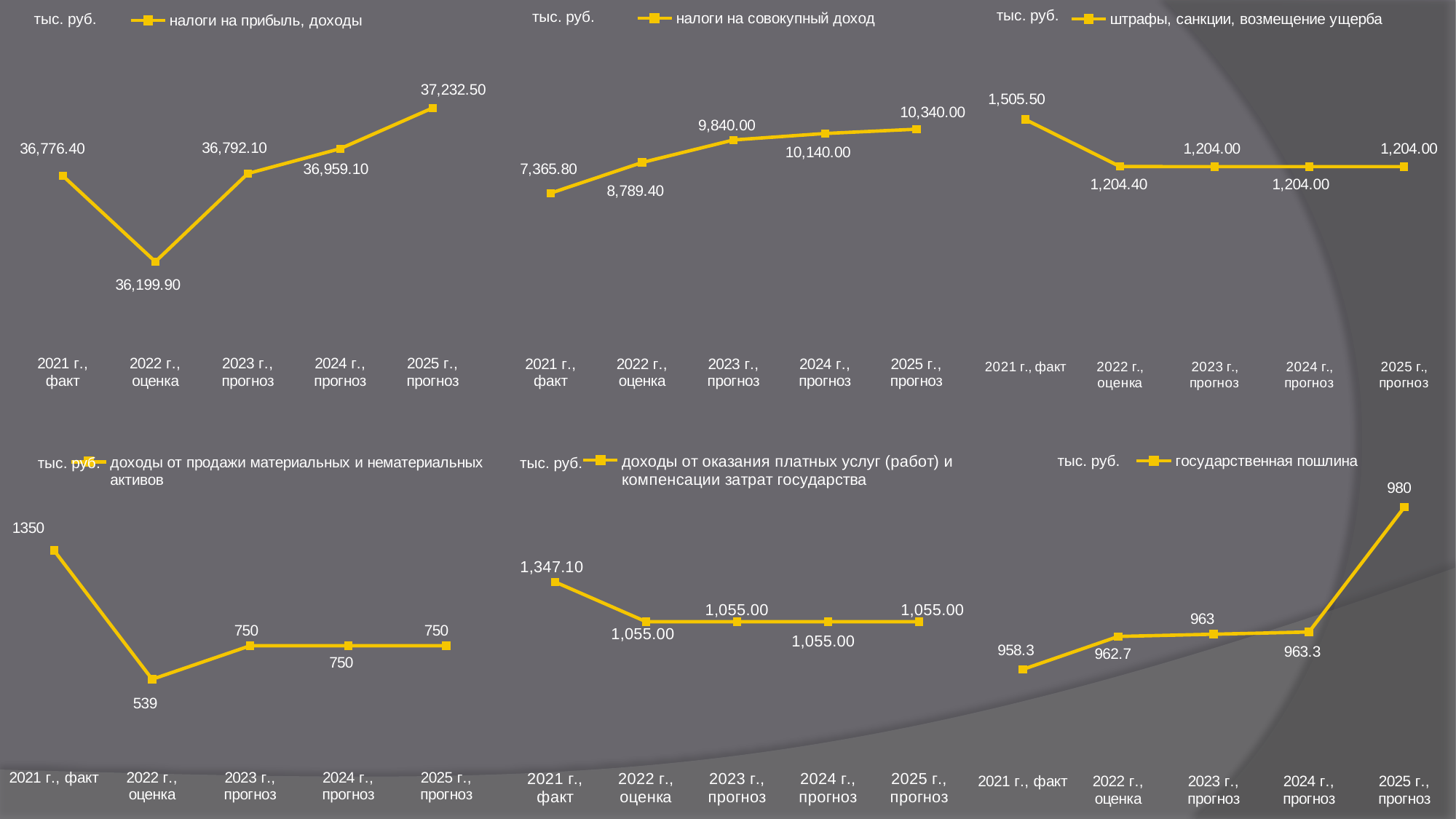
In the chart titled 'штрафы, санкции, возмещение ущерба', what is the value for 2021 г., факт? 1,505.50 In the chart titled 'налоги на прибыль, доходы', which year has the highest value? 2025 г., прогноз In the chart titled 'налоги на совокупный доход', what is the difference between the 2025 г., прогноз value and the 2021 г., факт value? 2,974.20 In the chart titled 'доходы от продажи материальных и нематериальных активов', what is the difference between the 2021 г., факт value and the 2022 г., оценка value? 811 In the chart titled 'налоги на совокупный доход', what is the value for 2021 г., факт? 7,365.80 In the chart titled 'штрафы, санкции, возмещение ущерба', which year has the lowest value? 2023 г., 2024 г. and 2025 г., прогноз (tied at 1,204.00) How many charts are on the slide, and what type of chart are they? 6 line charts In the chart titled 'налоги на прибыль, доходы', what is the value for 2022 г., оценка? 36,199.90 In the chart titled 'государственная пошлина', what is the value for 2025 г., прогноз? 980 In the chart titled 'доходы от продажи материальных и нематериальных активов', what is the value for 2022 г., оценка? 539 In the chart titled 'налоги на совокупный доход', do the values rise or fall from 2021 to 2025? rise In the chart titled 'доходы от оказания платных услуг (работ) и компенсации затрат государства', which is larger: the value for 2021 г., факт or for 2023 г., прогноз? 2021 г., факт